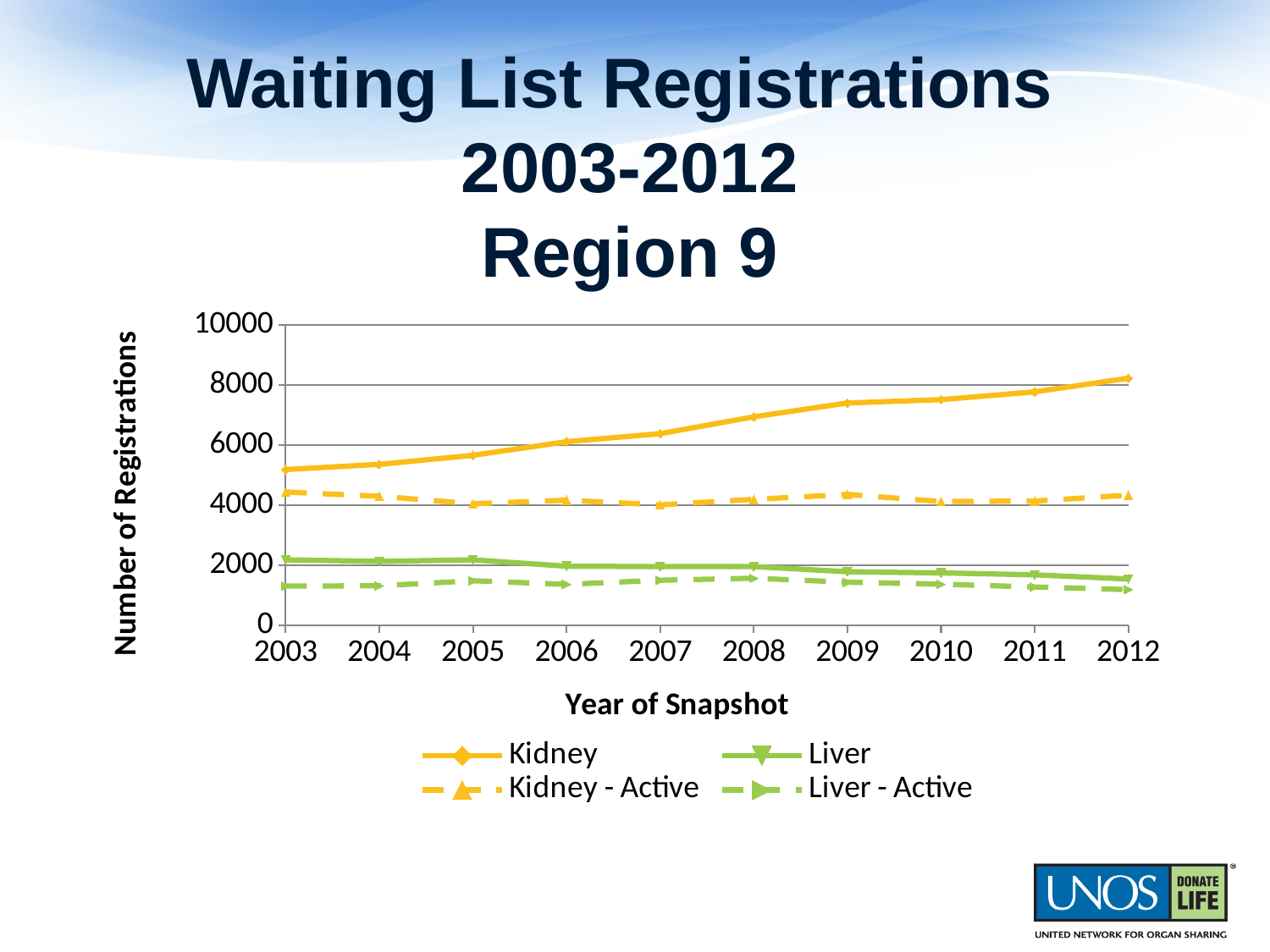
What kind of chart is shown on the slide? line chart How many series does the legend list? 4 Is the value for Kidney in 2012 greater or less than 8000? greater What is the label of the y axis? Number of Registrations Which series has the highest value in 2012? Kidney Which series has the lowest value in 2012? Liver - Active What is the label of the x axis? Year of Snapshot Is the value for Liver in 2012 greater or less than 2000? less Which is larger in 2012, the Kidney value or the Liver value? Kidney How many years are plotted along the x axis? 10 Is the value for Kidney in 2003 greater or less than 6000? less Does the Kidney series rise or fall from 2003 to 2012? rise